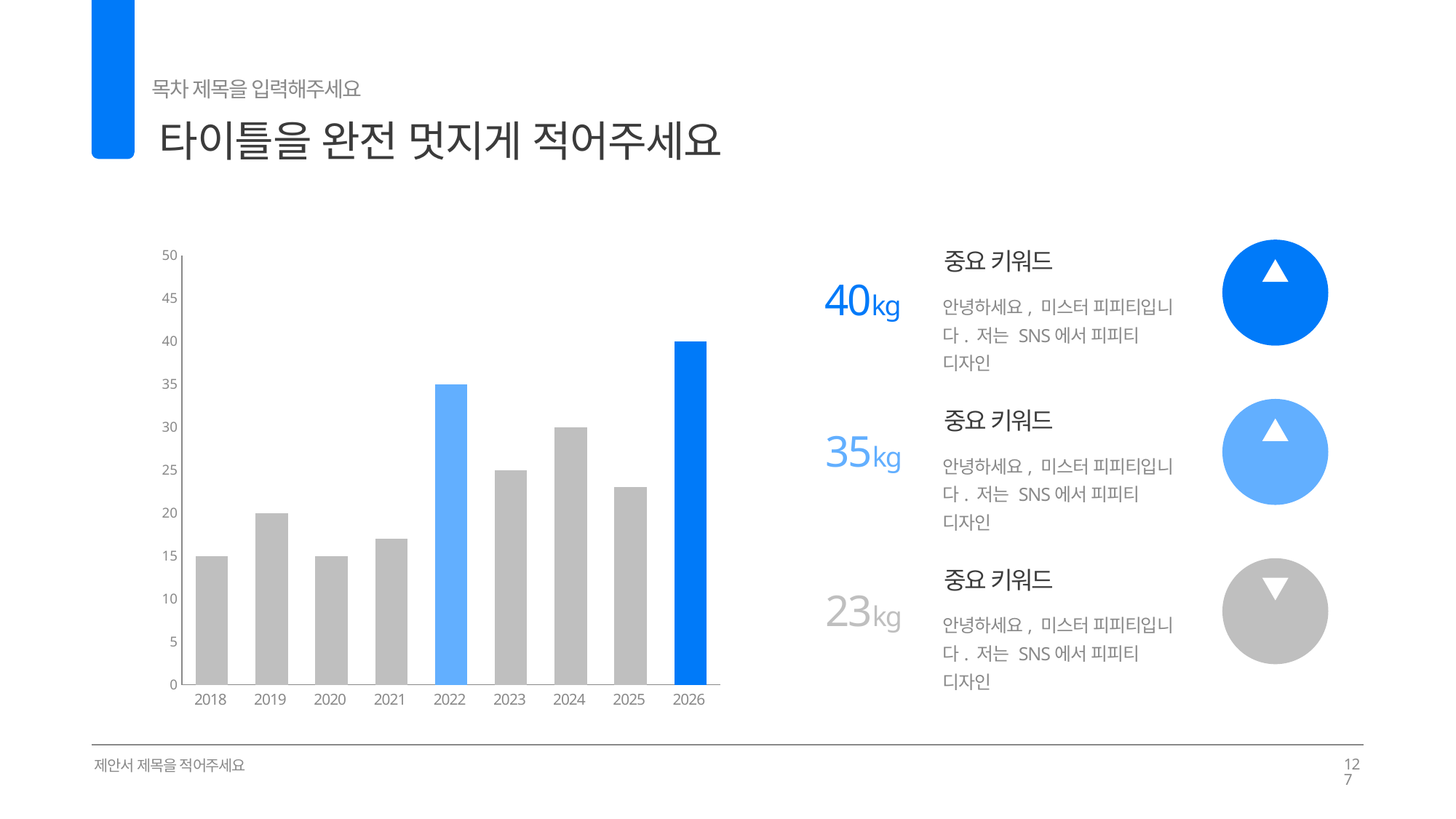
How many years are shown on the x axis of the chart? 9 What kind of chart is shown on the slide? bar chart Is the value for 2021 greater or less than 20? less What is the value of the bar for 2019? 20 What is the value of the bar for 2026? 40 What is the value of the bar for 2024? 30 What is the highest value shown on the chart's y axis? 50 Which year has the highest bar in the chart? 2026 What is the difference between the values for 2026 and 2022? 5 Is the value for 2025 greater or less than 20? greater Which is larger, the bar for 2023 or the bar for 2024? 2024 What is the value of the bar for 2022? 35